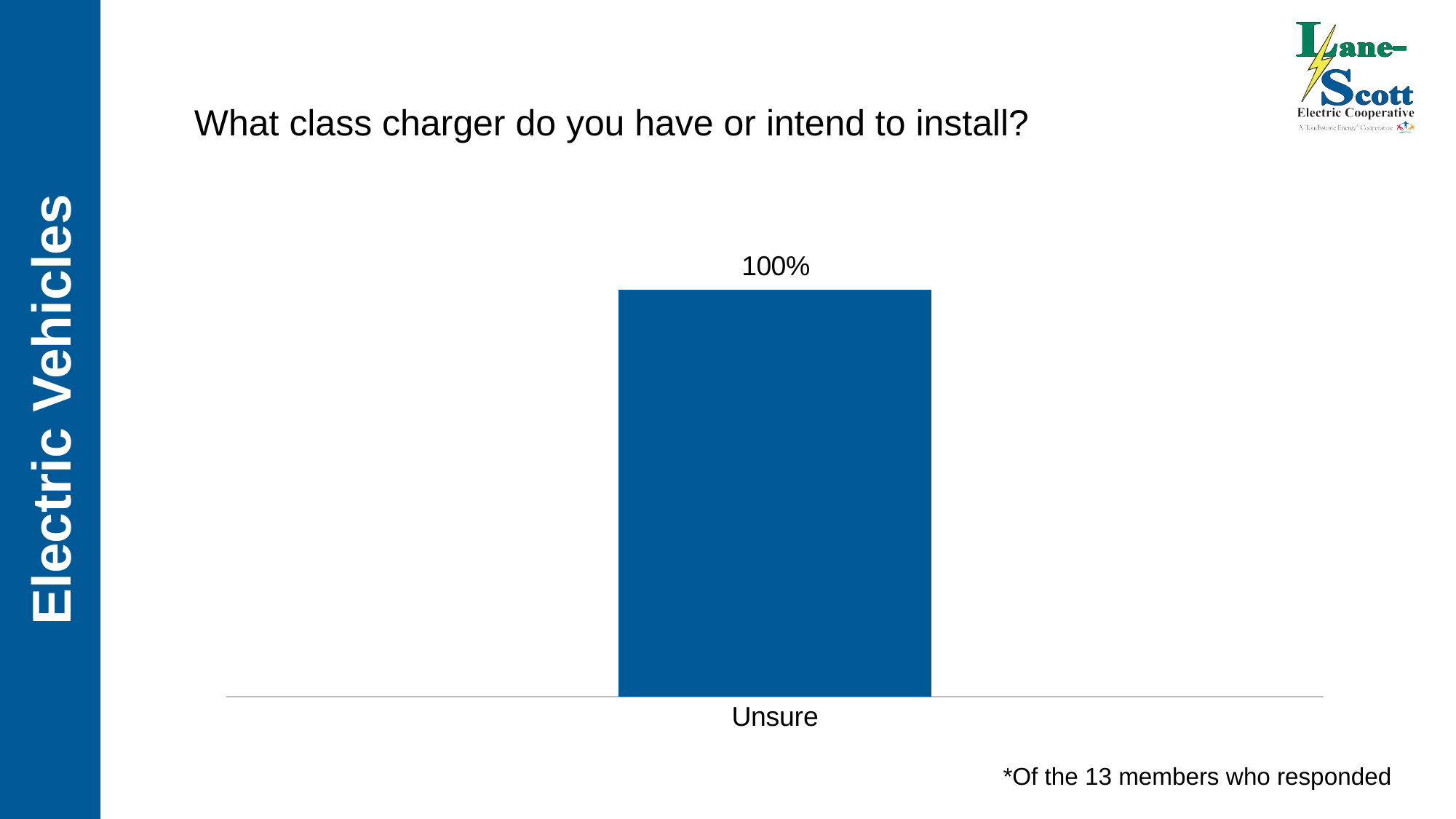
What kind of chart is shown on the slide? bar chart How many categories are plotted on the chart? 1 Which category has the highest value on the chart? Unsure What is the value shown for the Unsure category? 100% What question does the chart title ask? What class charger do you have or intend to install? What is the label of the only category on the x axis? Unsure